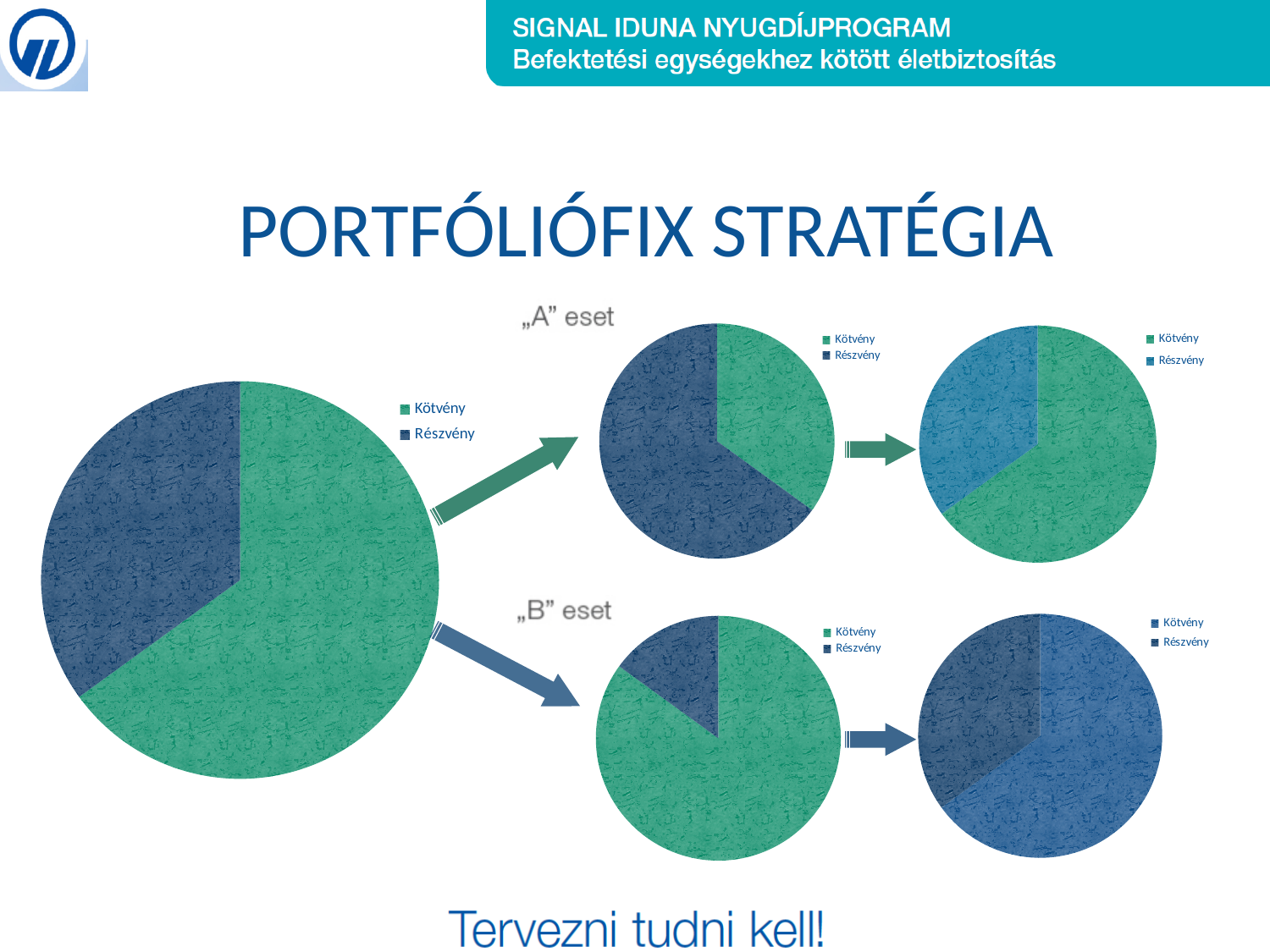
How many categories does each pie chart on the slide have? 2 In the rightmost pie chart of the "A" eset row, which category has the largest slice? Kötvény In the large left pie chart, which category has the largest slice? Kötvény What are the two legend entries of the large left pie chart? Kötvény, Részvény In the large left pie chart, which slice is larger, Kötvény or Részvény? Kötvény In the first (middle) pie chart of the "A" eset row, which slice is larger, Kötvény or Részvény? Részvény In the first (middle) pie chart of the "B" eset row, which slice is larger, Kötvény or Részvény? Kötvény How many pie charts are shown on the slide? 5 What kind of chart is the large chart on the left of the slide? pie chart How many series does the legend of the large left pie chart list? 2 In the large left pie chart, which category has the smallest slice? Részvény In the first (middle) pie chart of the "B" eset row, which category has the smallest slice? Részvény